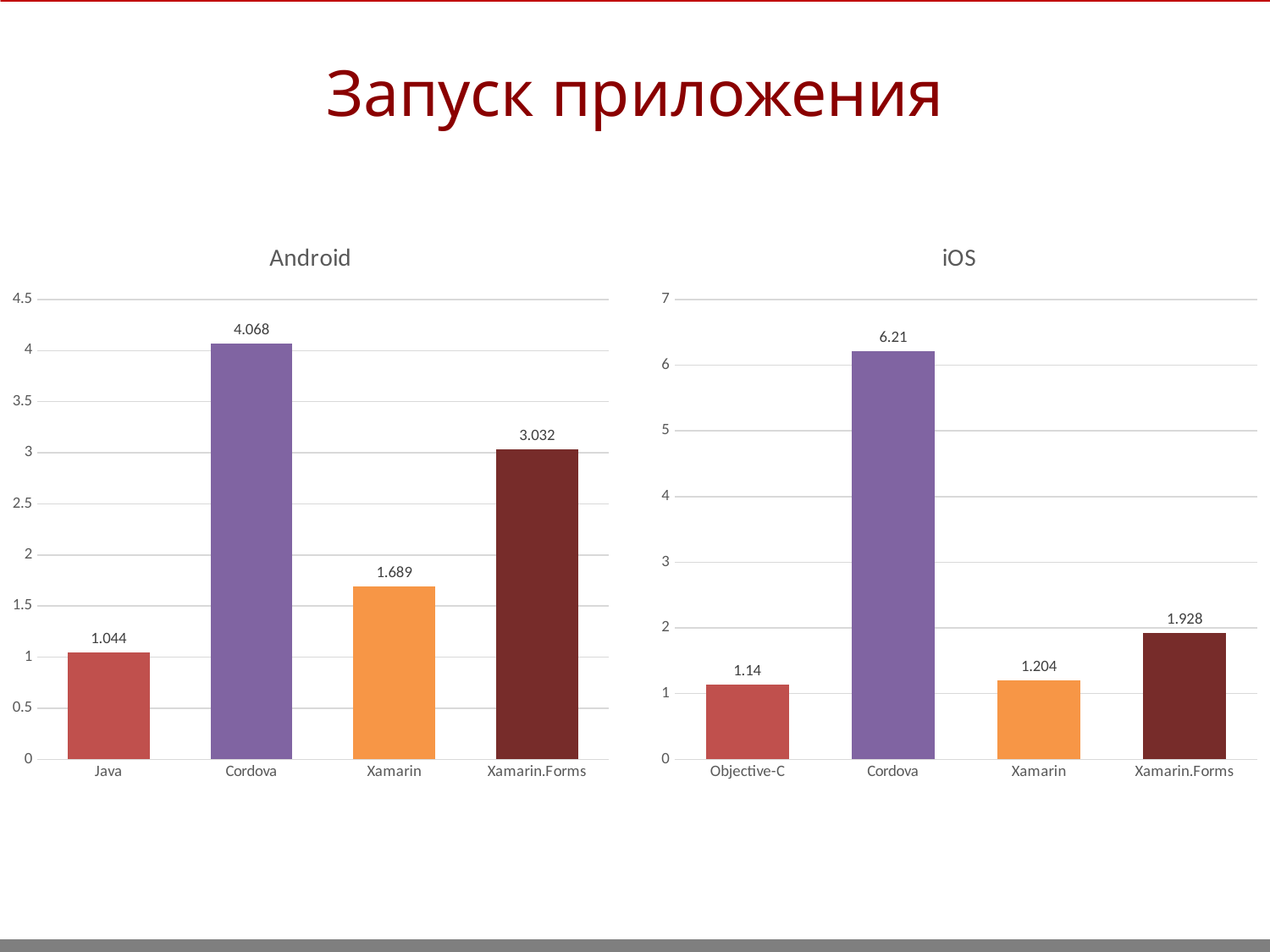
In the iOS chart, what is the difference between the values for Cordova and Objective-C? 5.07 How many categories are shown in the iOS chart? 4 In the iOS chart, which category has the highest value? Cordova In the Android chart, what is the difference between the values for Cordova and Xamarin.Forms? 1.036 What kind of chart is the Android chart? bar chart In the Android chart, which is larger, the value for Xamarin or the value for Xamarin.Forms? Xamarin.Forms In the iOS chart, what is the value for Xamarin.Forms? 1.928 In the Android chart, what is the value for Cordova? 4.068 In the Android chart, which category has the lowest value? Java What is the title of the slide? Запуск приложения In the Android chart, what is the value for Java? 1.044 In the iOS chart, which category has the lowest value? Objective-C